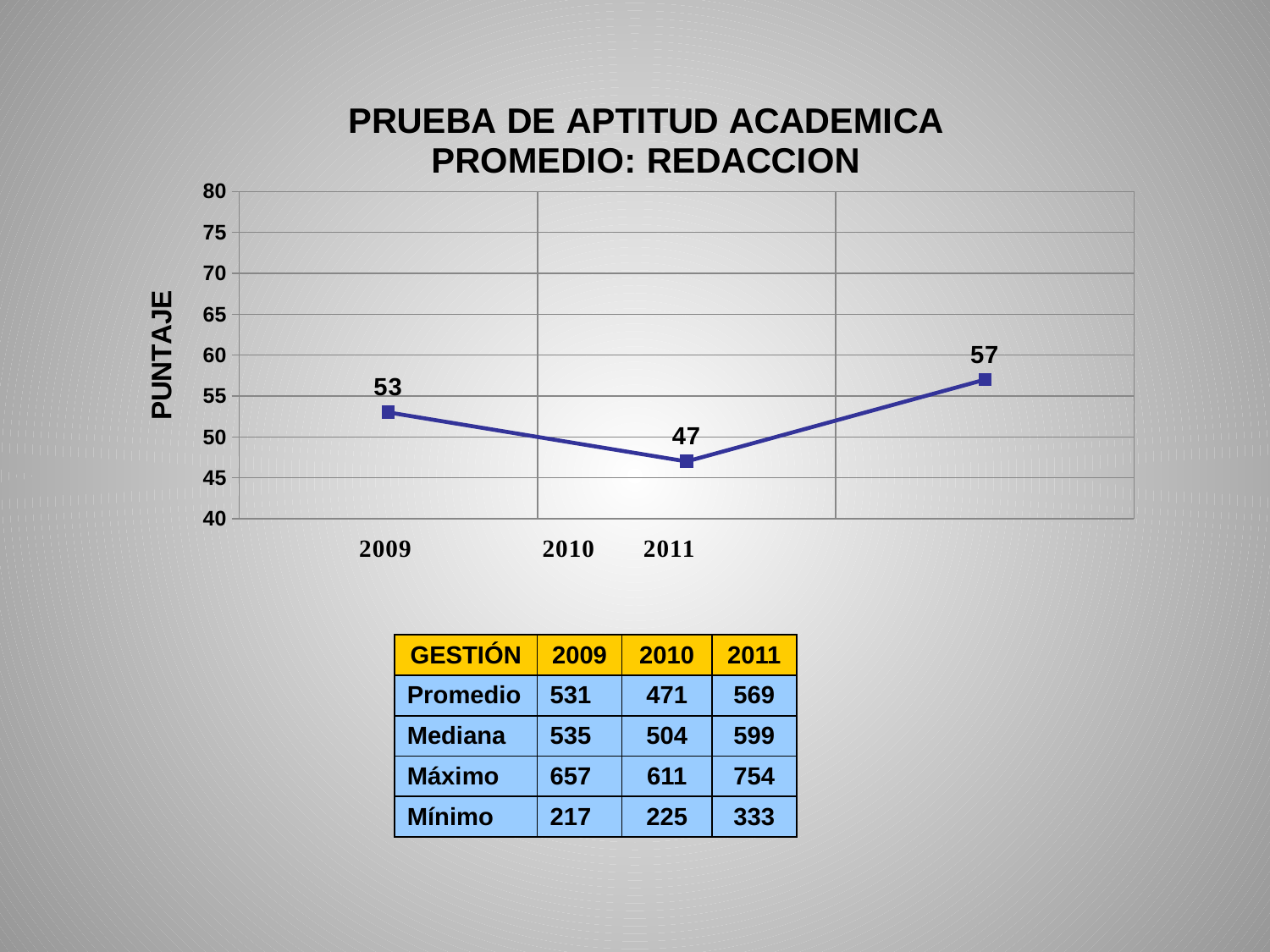
What is the value plotted for 2010? 47 Which year has the lowest value on the chart? 2010 What kind of chart is shown on the slide? line chart What is the title of the chart? PRUEBA DE APTITUD ACADEMICA PROMEDIO: REDACCION How many data points are plotted on the chart? 3 Is the value for 2010 greater or less than 50? less Which year has the highest value on the chart? 2011 What is the label of the vertical axis? PUNTAJE Which is larger, the value for 2009 or the value for 2011? 2011 What is the value plotted for 2011? 57 What is the value plotted for 2009? 53 What is the difference between the values for 2011 and 2010? 10